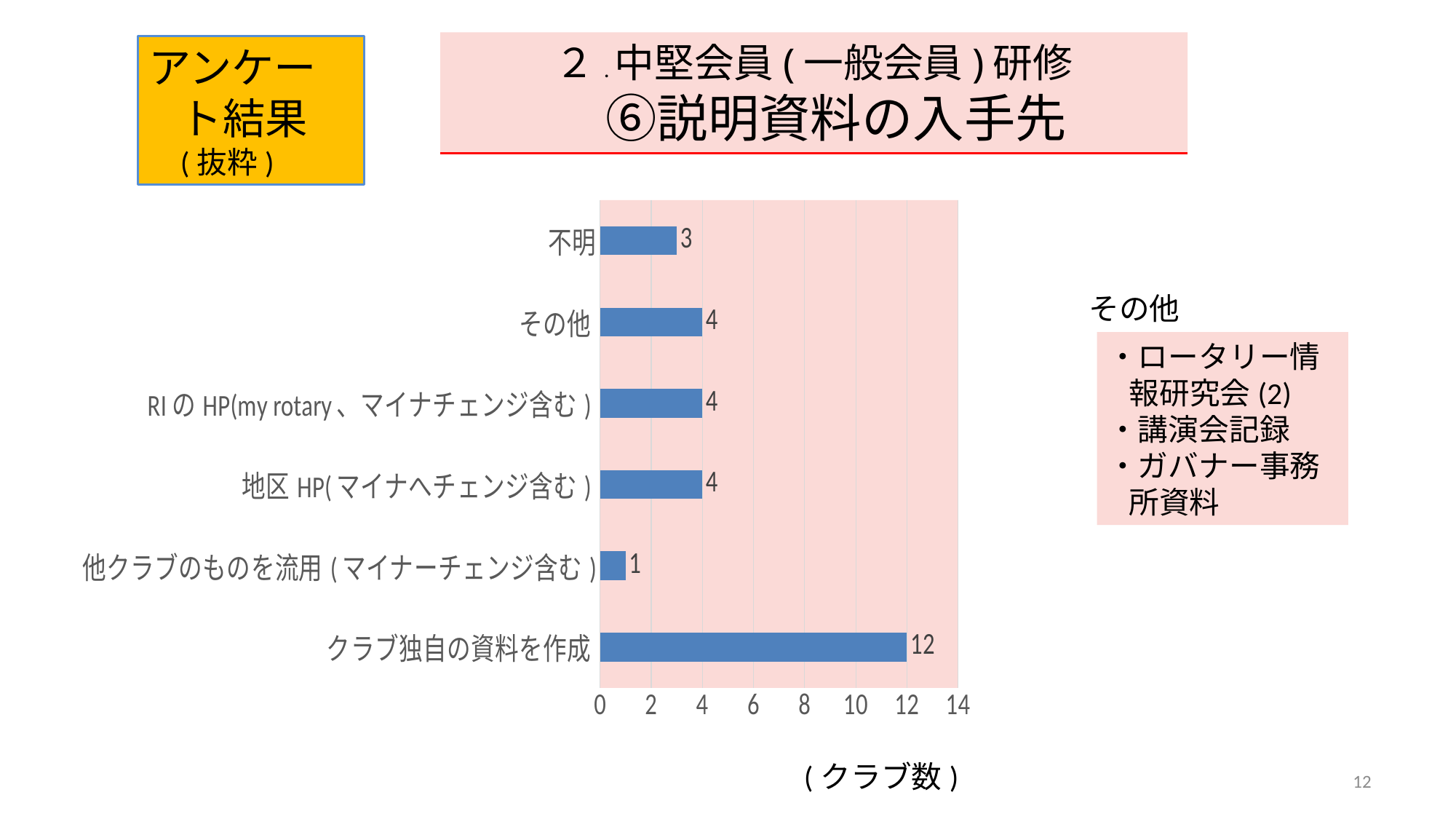
Which category has the lowest value? 他クラブのものを流用(マイナーチェンジ含む) What is the difference between the values for クラブ独自の資料を作成 and 不明? 9 What is the value for 他クラブのものを流用(マイナーチェンジ含む)? 1 Which is larger, the value for 不明 or the value for その他? その他 What is the value for 不明? 3 What is the value for その他? 4 How many categories are shown in the chart? 6 What kind of chart is shown on the slide? bar chart What unit is indicated below the chart's x axis? クラブ数 Which category has the highest value? クラブ独自の資料を作成 Is the value for クラブ独自の資料を作成 greater or less than 10? greater What is the value for クラブ独自の資料を作成? 12